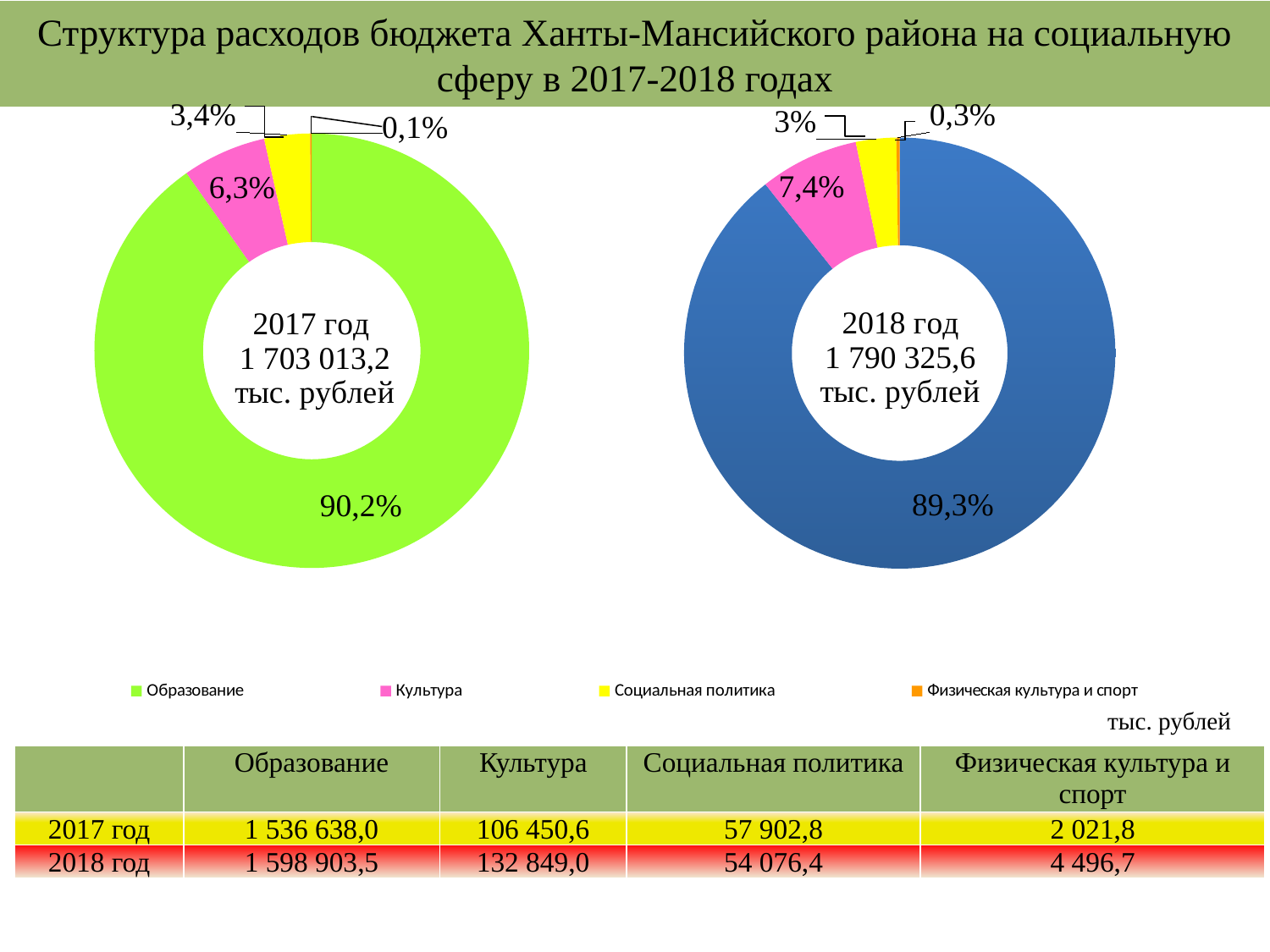
In the 2018 год chart, what share does the largest slice (Образование) have? 89,3% In the 2018 год chart, what share is shown for Физическая культура и спорт? 0,3% What is the difference between the Образование share in the 2017 год chart (90,2%) and in the 2018 год chart (89,3%)? 0,9% What total amount is printed in the centre of the 2018 год chart? 1 790 325,6 тыс. рублей How many categories does the legend list for the charts? 4 What type of chart is used on the slide for the 2017 and 2018 data? Doughnut (pie) chart In the 2018 год chart, what share is shown for Культура (the pink slice)? 7,4% Which is larger: the share of Культура in the 2017 год chart or in the 2018 год chart? 2018 год In the 2017 год chart, what share is shown for Культура (the pink slice)? 6,3% In the 2017 год chart, which category has the smallest share? Физическая культура и спорт In the 2017 год chart, what share is shown for Социальная политика (the yellow slice)? 3,4% In the 2017 год chart, what share does the largest slice (Образование) have? 90,2%